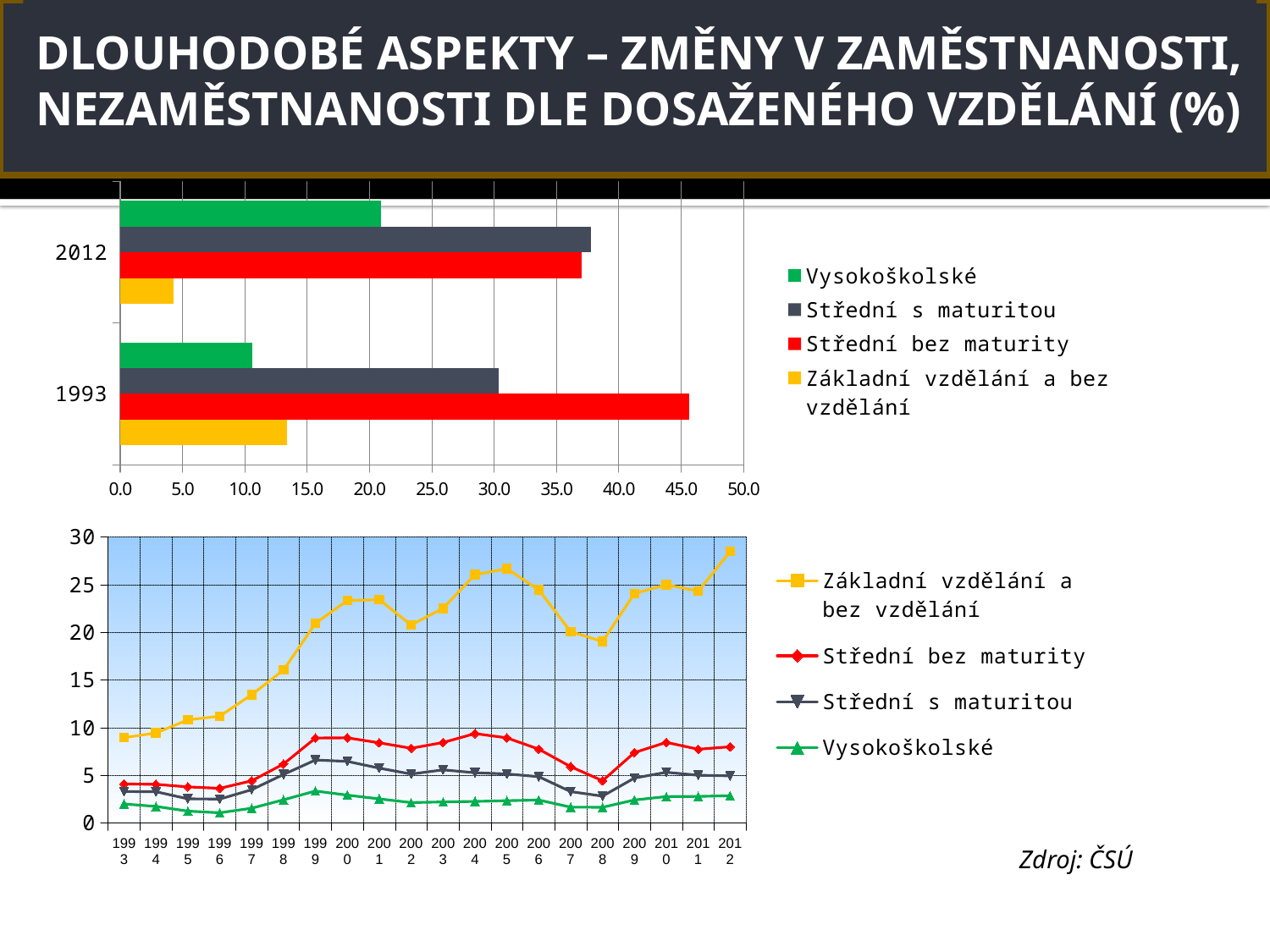
In the bottom chart, which series has the highest value in 2012? Základní vzdělání a bez vzdělání In the top chart, which series has the highest value for 1993? Střední bez maturity In the bottom chart, is the value for Základní vzdělání a bez vzdělání in 2012 greater or less than 25? greater In the top chart, is the value for Vysokoškolské in 2012 greater or less than 25.0? less In the top chart, is the value for Střední bez maturity in 1993 greater or less than 40.0? greater In the top chart, is the value for Vysokoškolské larger in 2012 or in 1993? 2012 What kind of chart is the bottom chart on the slide? line chart How many series does the legend of the top chart list? 4 How many series does the legend of the bottom chart list? 4 In the bottom chart, does the Základní vzdělání a bez vzdělání series rise or fall overall from 1993 to 2012? rise In the top chart, which series has the lowest value for 2012? Základní vzdělání a bez vzdělání What kind of chart is the top chart on the slide? bar chart